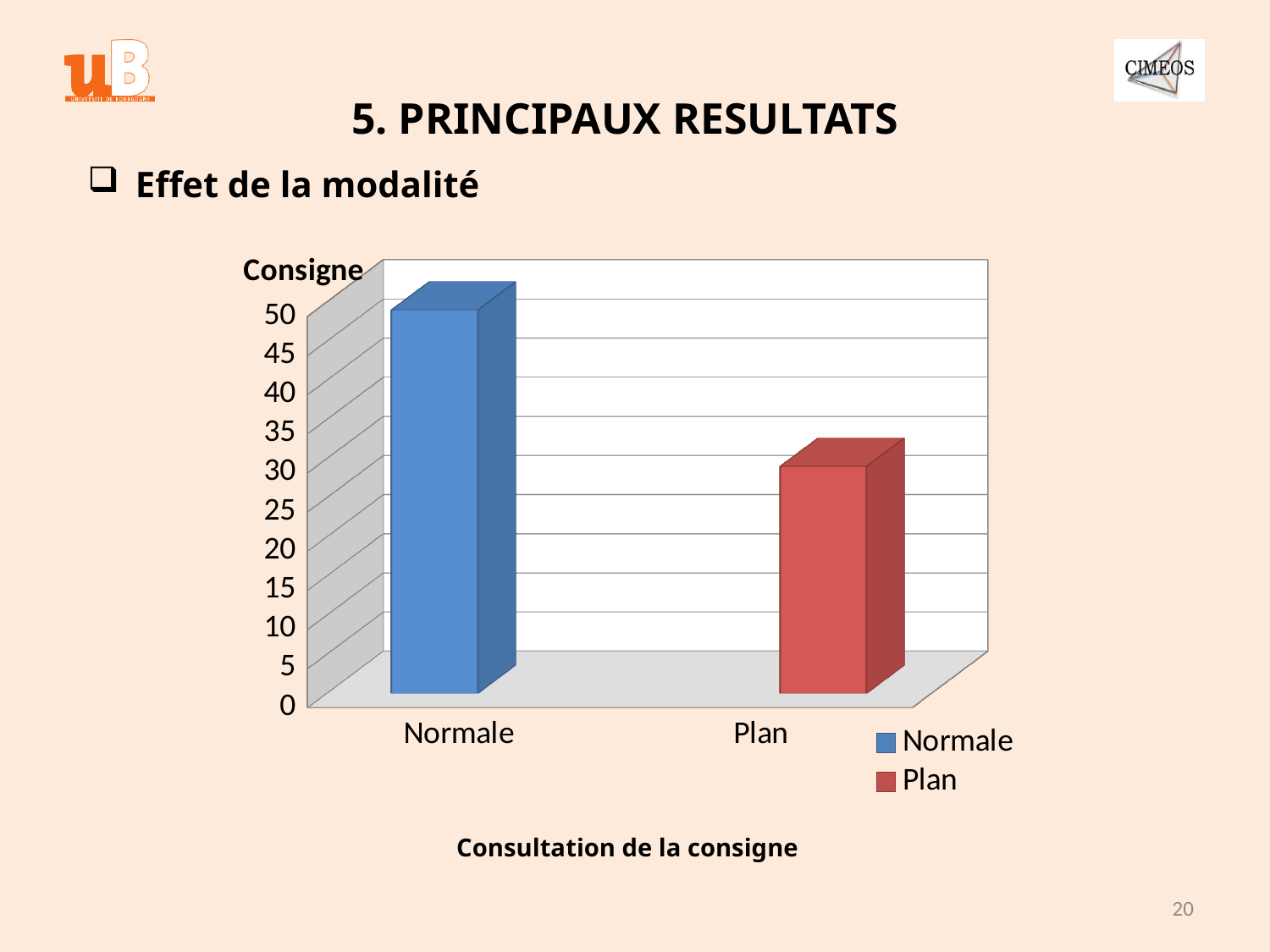
How many bars (categories) are plotted in the chart? 2 What kind of chart is shown on the slide? bar chart What are the two entries listed in the chart legend? Normale and Plan Which category has the highest bar in the chart? Normale Is the value for Plan greater or less than 20? greater What caption is written below the chart? Consultation de la consigne Is the value for Normale greater or less than 45? greater Which category has the lowest bar in the chart? Plan Which bar is taller, Normale or Plan? Normale Is the value for Plan greater or less than 40? less How many entries does the chart legend list? 2